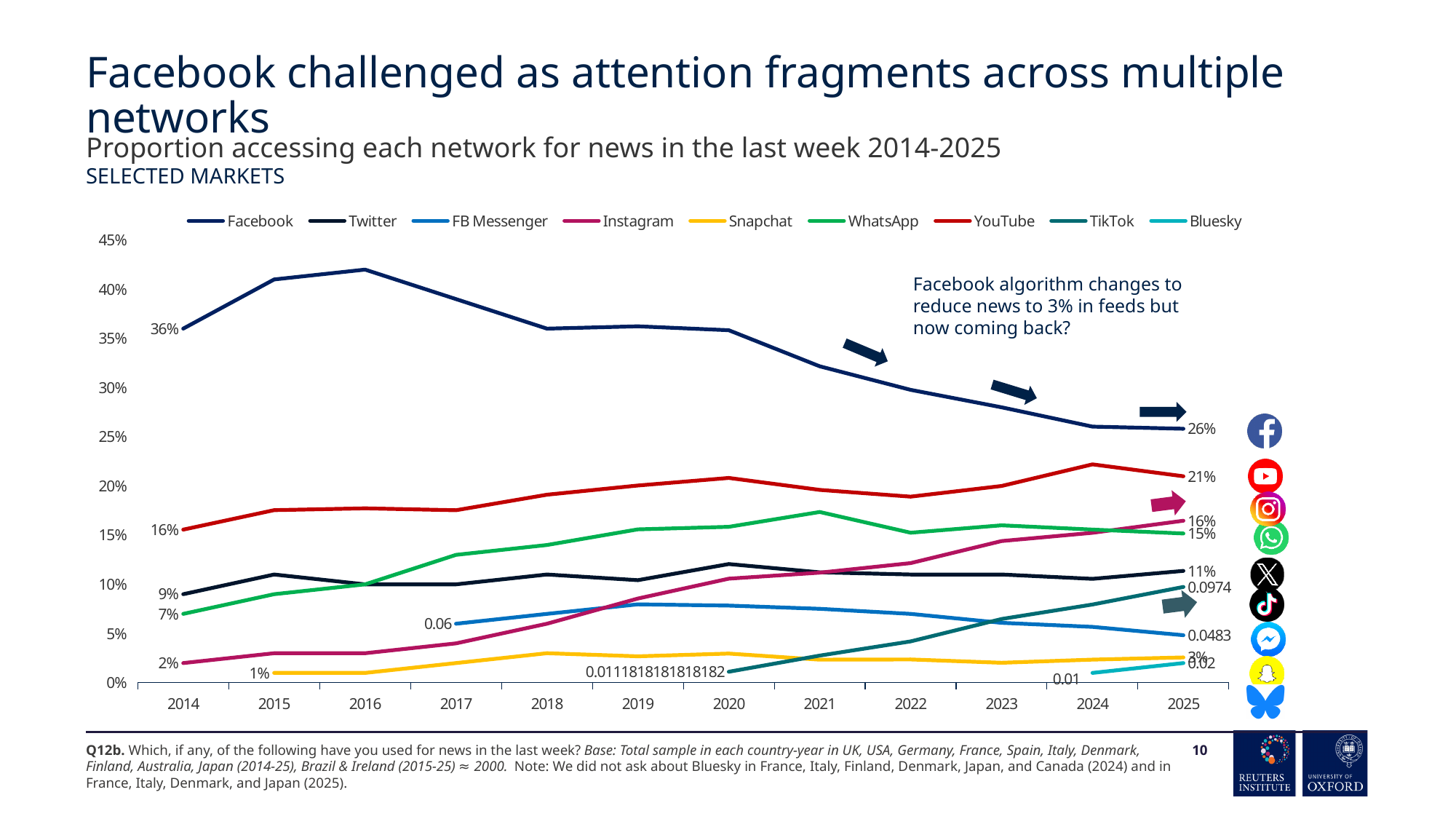
In 2025, which was larger: YouTube or WhatsApp? YouTube What was the value for WhatsApp in 2014? 7% Which network had the highest value in 2025? Facebook What was the value for YouTube in 2025? 21% By how many percentage points did Facebook's value fall between 2014 and 2025? 10 percentage points How many series does the legend list? 9 What was the proportion accessing Facebook for news in 2014? 36% What was the proportion accessing Facebook for news in 2025? 26% What was the value for Instagram in 2025? 16% What kind of chart is shown on the slide? line chart How many years are shown on the x axis? 12 Is the value for Facebook in 2016 greater or less than 40%? greater